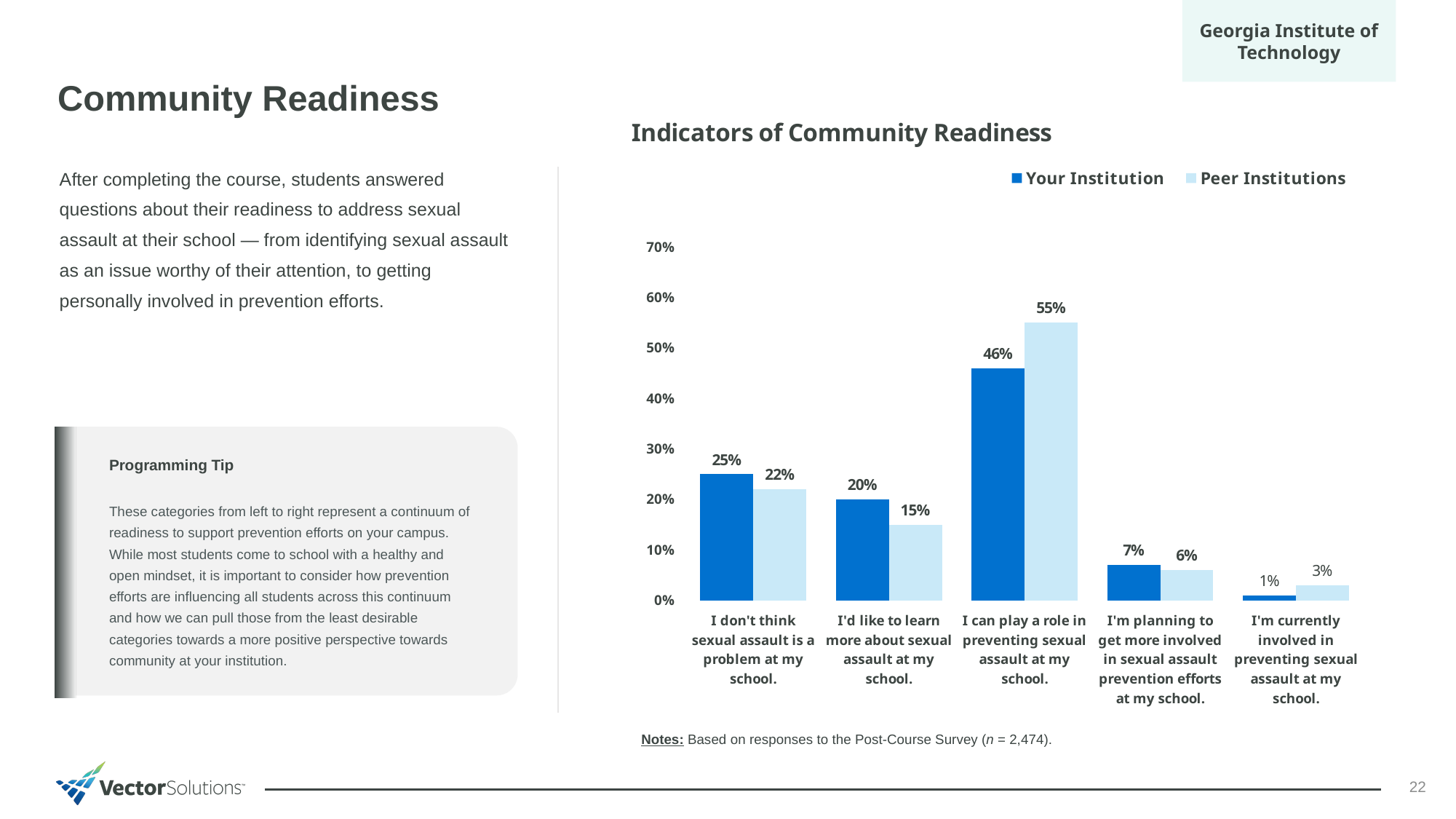
What is the title of the chart? Indicators of Community Readiness What is the Peer Institutions value for "I'd like to learn more about sexual assault at my school."? 15% What is the Your Institution value for "I'm currently involved in preventing sexual assault at my school."? 1% For "I don't think sexual assault is a problem at my school.", which is larger: Your Institution or Peer Institutions? Your Institution How many categories are shown on the x axis? 5 Which category has the highest Peer Institutions value? I can play a role in preventing sexual assault at my school. Which category has the lowest Your Institution value? I'm currently involved in preventing sexual assault at my school. What is the Your Institution value for "I can play a role in preventing sexual assault at my school."? 46% What is the difference between the Peer Institutions and Your Institution values for "I can play a role in preventing sexual assault at my school."? 9% How many series does the legend list? 2 Is the Your Institution value for "I'd like to learn more about sexual assault at my school." greater or less than 30%? less What kind of chart is shown? bar chart